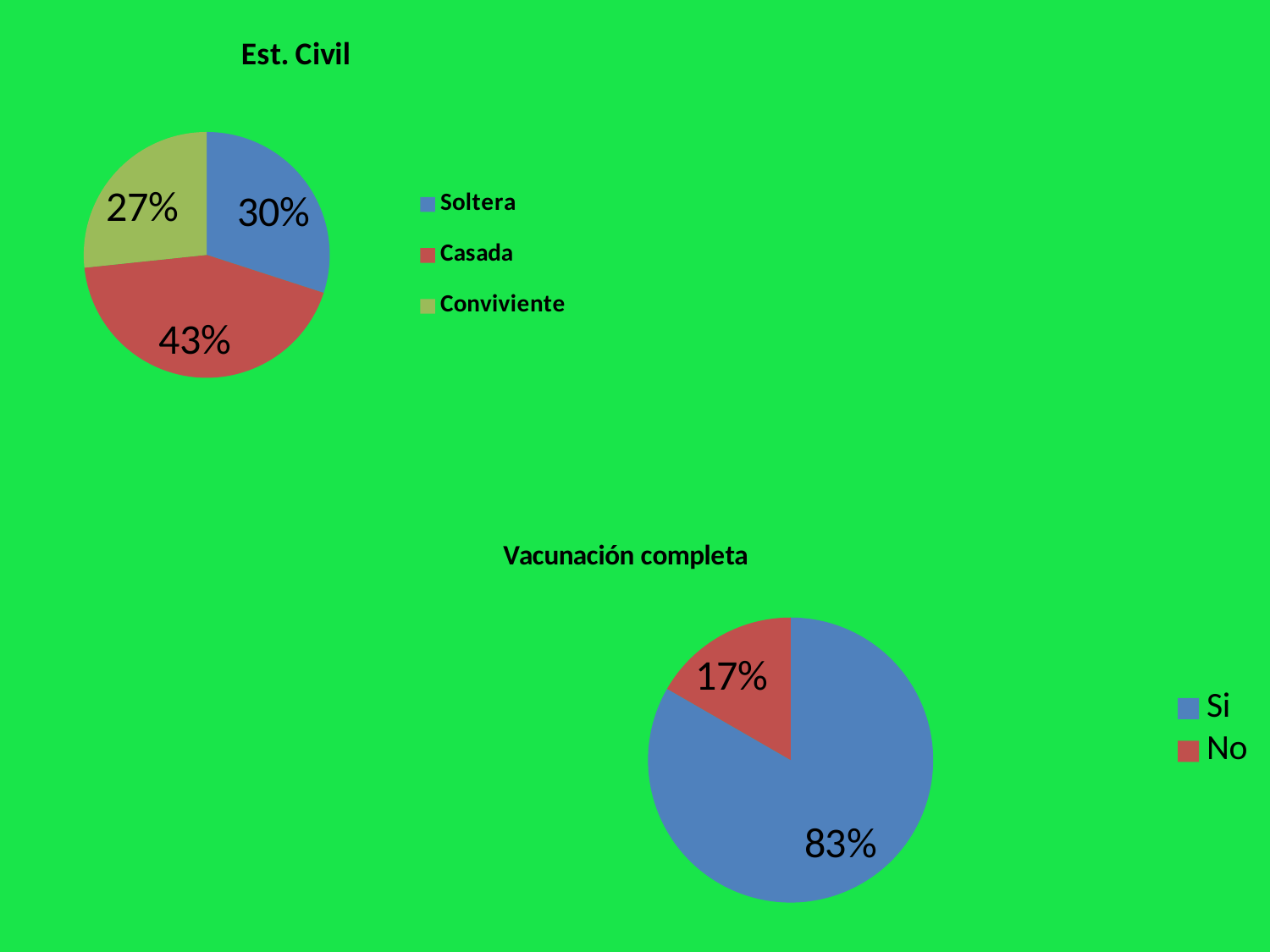
In the 'Est. Civil' chart, what percentage is shown for Conviviente? 27% In the 'Est. Civil' chart, what percentage is shown for Soltera? 30% In the 'Est. Civil' chart, which category has the smallest share? Conviviente In the 'Est. Civil' chart, what is the difference in percentage points between Casada and Soltera? 13 In the 'Vacunación completa' chart, which is larger, Si or No? Si In the 'Vacunación completa' chart, what colour is the slice for No? Red In the 'Vacunación completa' chart, what percentage is shown for Si? 83% In the 'Vacunación completa' chart, what percentage is shown for No? 17% In the 'Est. Civil' chart, what percentage is shown for Casada? 43% What kind of chart is the 'Est. Civil' chart? Pie chart In the 'Est. Civil' chart, which category has the largest share? Casada In the 'Est. Civil' chart, how many categories does the legend list? 3